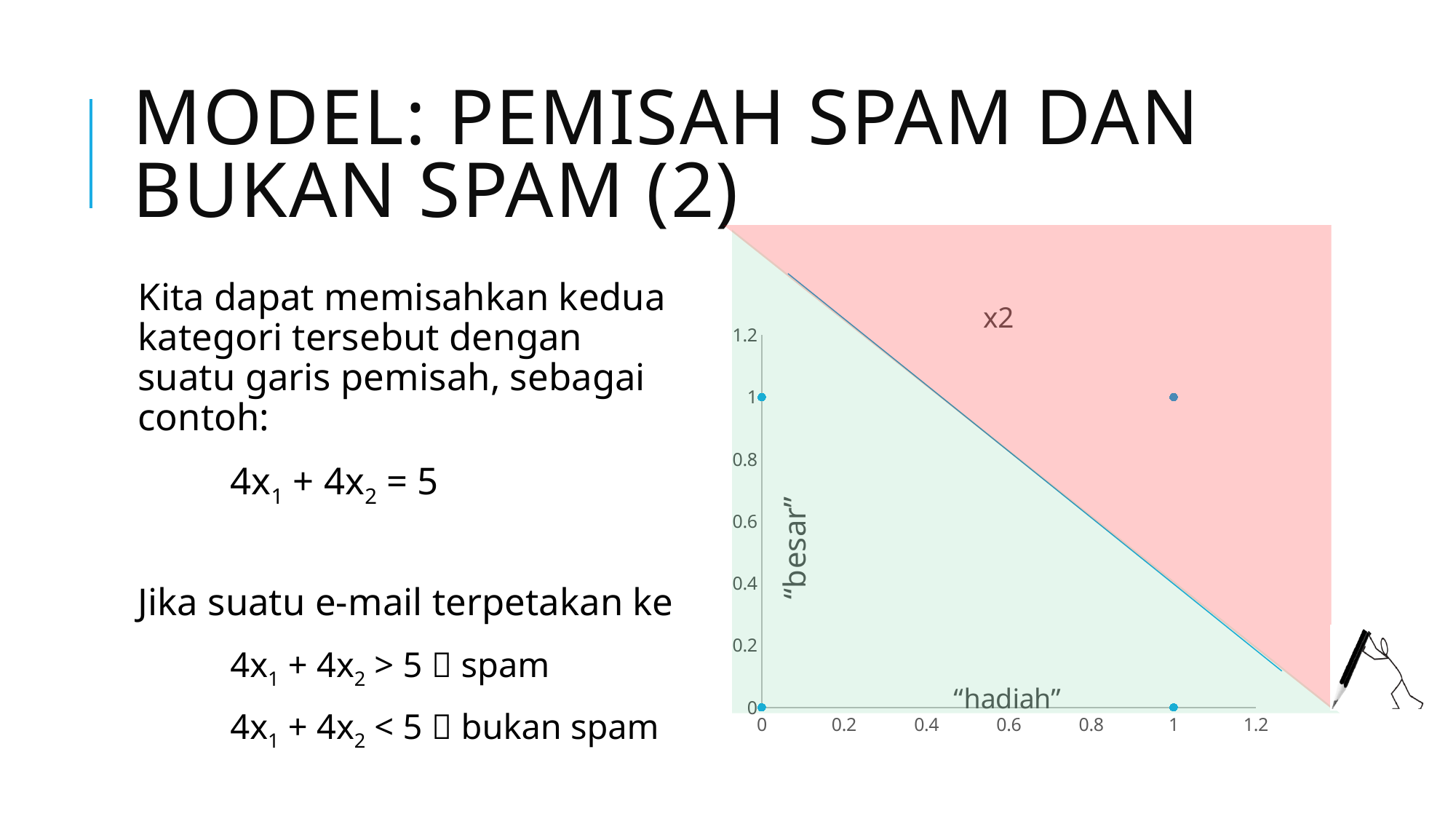
What is the label on the vertical axis of the chart? "besar" What is the "besar" value of the point that lies on the horizontal axis at "hadiah" = 1? 0 How many data points are plotted on the chart? 4 What is the label on the horizontal axis of the chart? "hadiah" How many of the plotted points lie in the red (spam) region? 1 Is the "besar" value of the point in the red region greater or less than 0.6? greater Which point has the larger "hadiah" value: the point at the top of the vertical axis or the point in the red region? the point in the red region What is the "hadiah" value of the point plotted in the upper-right (red) region? 1 What kind of chart is shown on the slide? scatter chart What is the highest tick value shown on the vertical axis? 1.2 What is the "besar" value of the point plotted in the upper-right (red) region? 1 What is the highest tick value shown on the horizontal axis? 1.2